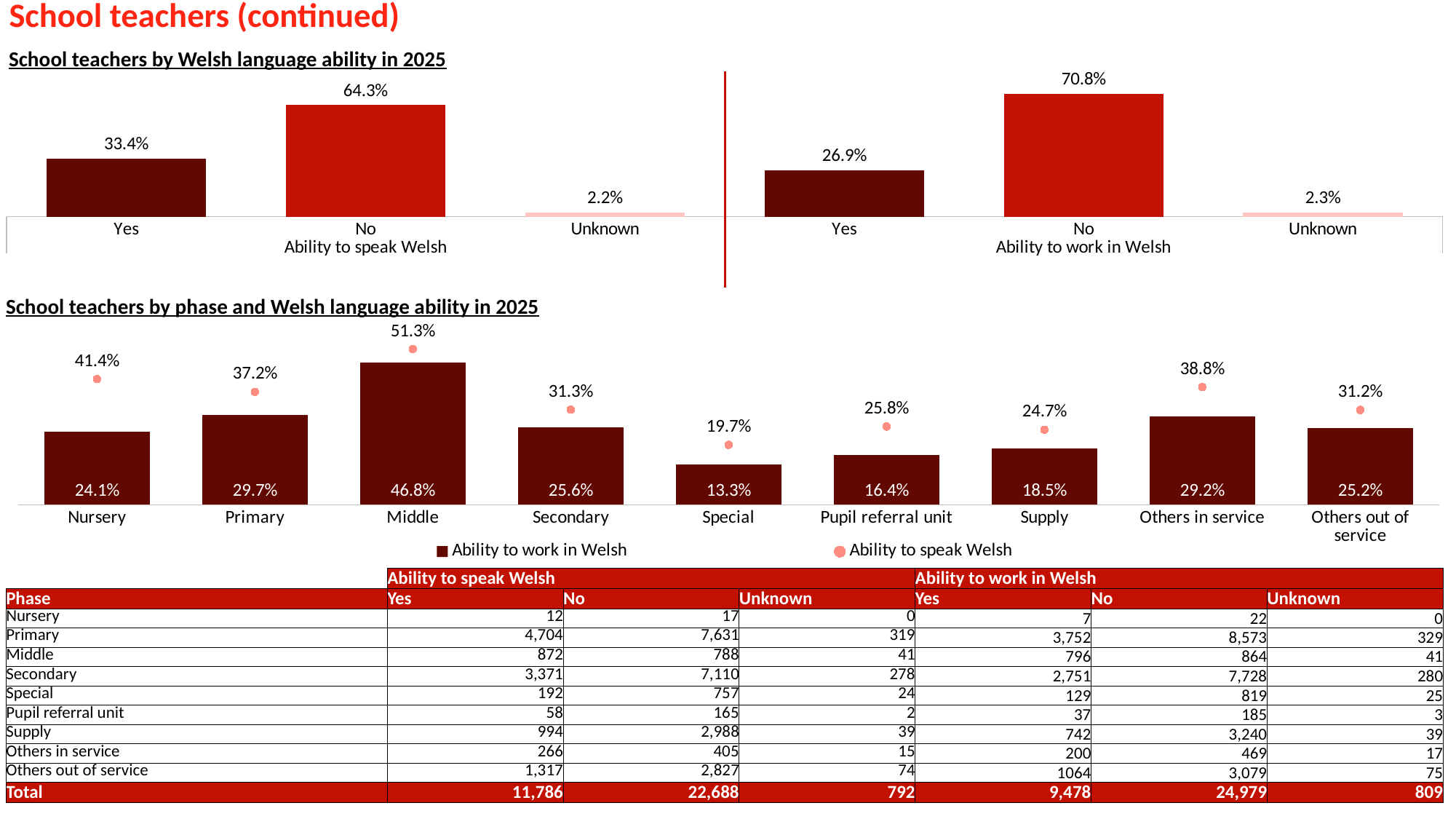
In the 'School teachers by phase and Welsh language ability in 2025' chart, which phase has the lowest 'Ability to speak Welsh' percentage? Special In the 'School teachers by phase and Welsh language ability in 2025' chart, what is the difference between the 'Ability to speak Welsh' and 'Ability to work in Welsh' percentages for Nursery? 17.3% In the 'School teachers by Welsh language ability in 2025' chart, what percentage of school teachers have the ability to speak Welsh (Yes)? 33.4% In the 'School teachers by phase and Welsh language ability in 2025' chart, what is the 'Ability to speak Welsh' percentage for Middle? 51.3% In the 'School teachers by Welsh language ability in 2025' chart, what is the difference between the 'No' and 'Yes' percentages for ability to work in Welsh? 43.9% In the 'School teachers by Welsh language ability in 2025' chart, which is larger: the 'Yes' percentage for ability to speak Welsh or the 'Yes' percentage for ability to work in Welsh? Ability to speak Welsh How many phases are shown on the x axis of the 'School teachers by phase and Welsh language ability in 2025' chart? 9 In the 'School teachers by Welsh language ability in 2025' chart, what percentage of school teachers are recorded as 'No' for ability to work in Welsh? 70.8% How many series does the legend of the 'School teachers by phase and Welsh language ability in 2025' chart list? 2 In the 'School teachers by phase and Welsh language ability in 2025' chart, what is the 'Ability to work in Welsh' percentage for Special? 13.3% In the 'School teachers by Welsh language ability in 2025' chart, which category is lowest for ability to speak Welsh? Unknown In the 'School teachers by phase and Welsh language ability in 2025' chart, which phase has the highest 'Ability to work in Welsh' percentage? Middle